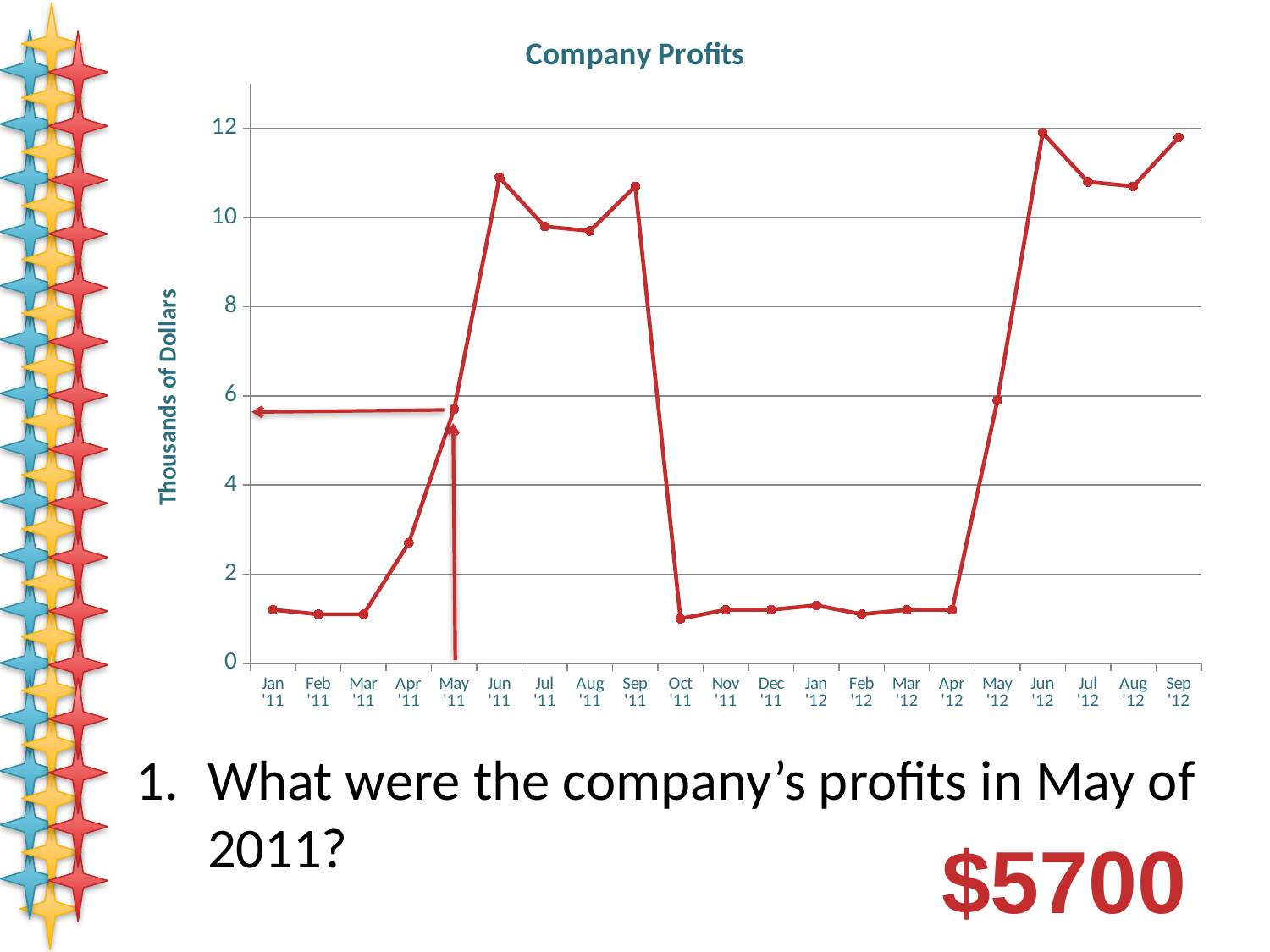
Do the values rise or fall from Mar '11 to Jun '11? rise Is the value for May '12 greater or less than 4? greater How many monthly data points are plotted on the chart? 21 According to the slide, what were the company's profits in May of 2011? $5700 What type of chart is shown on the slide? line chart Is the value for Apr '11 greater or less than 2? greater What is the label on the vertical axis of the chart? Thousands of Dollars Which is larger, the value for Jun '11 or the value for Jul '11? Jun '11 Which is larger, the value for Sep '11 or the value for Oct '11? Sep '11 Is the value for Oct '11 greater or less than 2? less What is the title of the chart? Company Profits